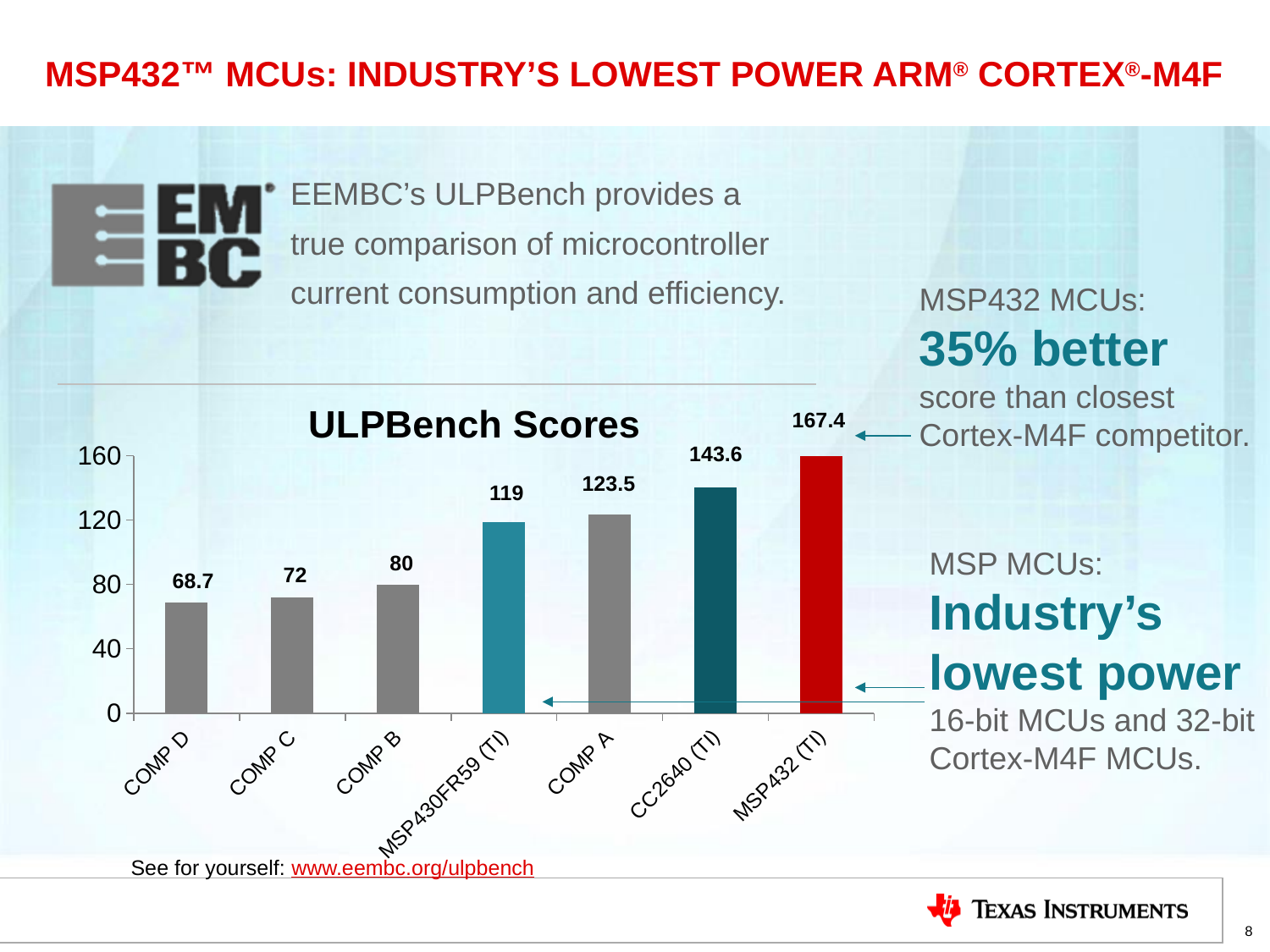
What is the ULPBench score for MSP432 (TI)? 167.4 Which has a higher ULPBench score, CC2640 (TI) or COMP A? CC2640 (TI) What is the difference between the ULPBench scores of COMP B and COMP C? 8 What is the ULPBench score for MSP430FR59 (TI)? 119 What kind of chart is the ULPBench Scores chart? Bar chart Which category has the highest ULPBench score? MSP432 (TI) What is the ULPBench score for CC2640 (TI)? 143.6 What is the difference between the ULPBench scores of MSP432 (TI) and COMP A? 43.9 What is the ULPBench score for COMP D? 68.7 How many categories are shown in the ULPBench Scores chart? 7 Do the ULPBench scores rise or fall from left to right along the x axis? Rise Which category has the lowest ULPBench score? COMP D